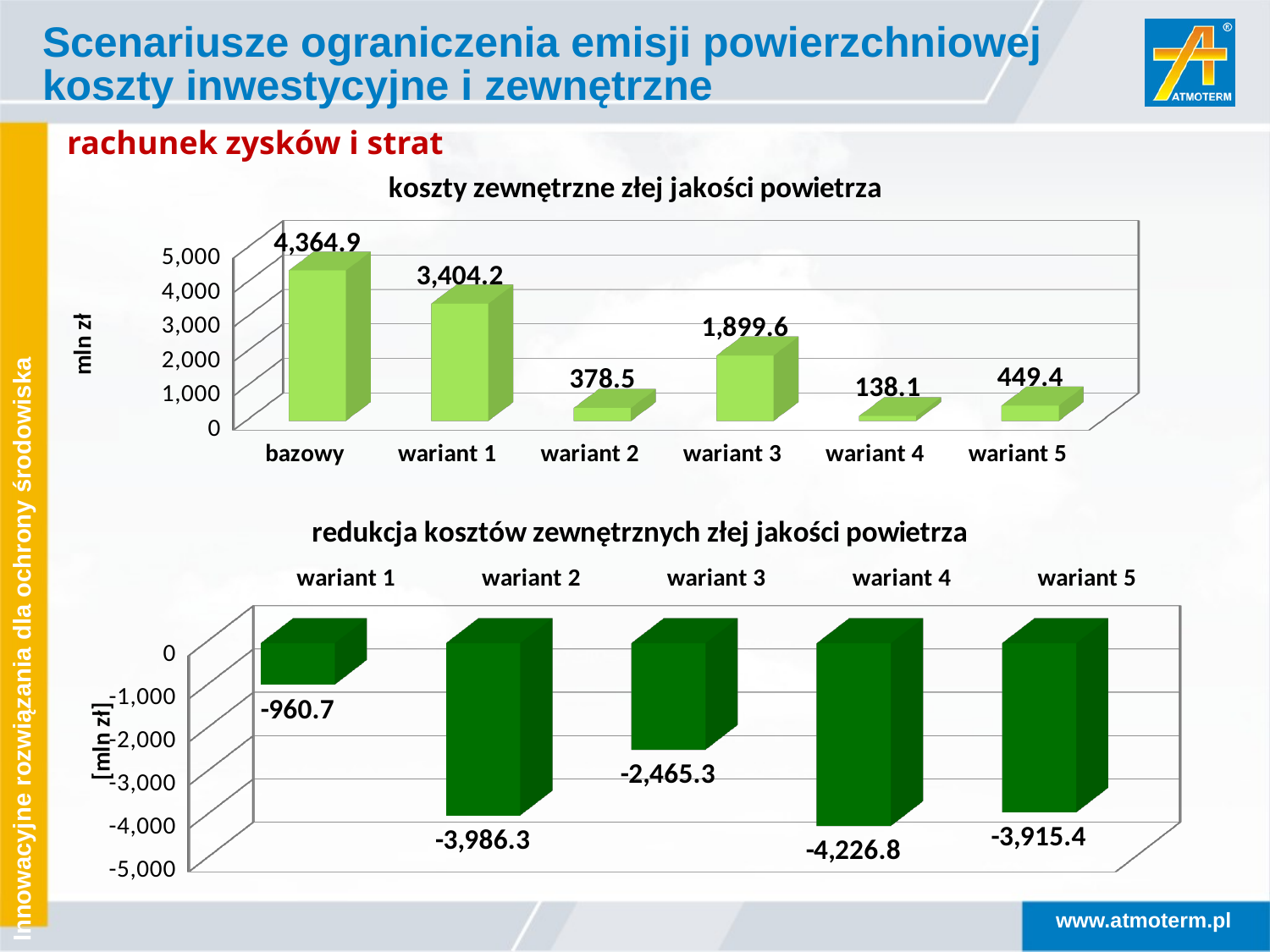
In the chart 'redukcja kosztów zewnętrznych złej jakości powietrza', what is the value for wariant 4? -4,226.8 In the chart 'koszty zewnętrzne złej jakości powietrza', what is the value for wariant 3? 1,899.6 In the chart 'koszty zewnętrzne złej jakości powietrza', what is the value for bazowy? 4,364.9 In the chart 'redukcja kosztów zewnętrznych złej jakości powietrza', how many categories are shown? 5 In the chart 'koszty zewnętrzne złej jakości powietrza', which category has the lowest value? wariant 4 In the chart 'redukcja kosztów zewnętrznych złej jakości powietrza', which category has the lowest (most negative) value? wariant 4 What type of chart is 'koszty zewnętrzne złej jakości powietrza'? bar chart In the chart 'koszty zewnętrzne złej jakości powietrza', which category has the highest value? bazowy In the chart 'koszty zewnętrzne złej jakości powietrza', how many categories are shown? 6 In the chart 'koszty zewnętrzne złej jakości powietrza', what is the difference between bazowy and wariant 1? 960.7 In the chart 'redukcja kosztów zewnętrznych złej jakości powietrza', is the value for wariant 2 or wariant 3 more negative? wariant 2 In the chart 'redukcja kosztów zewnętrznych złej jakości powietrza', what is the value for wariant 1? -960.7